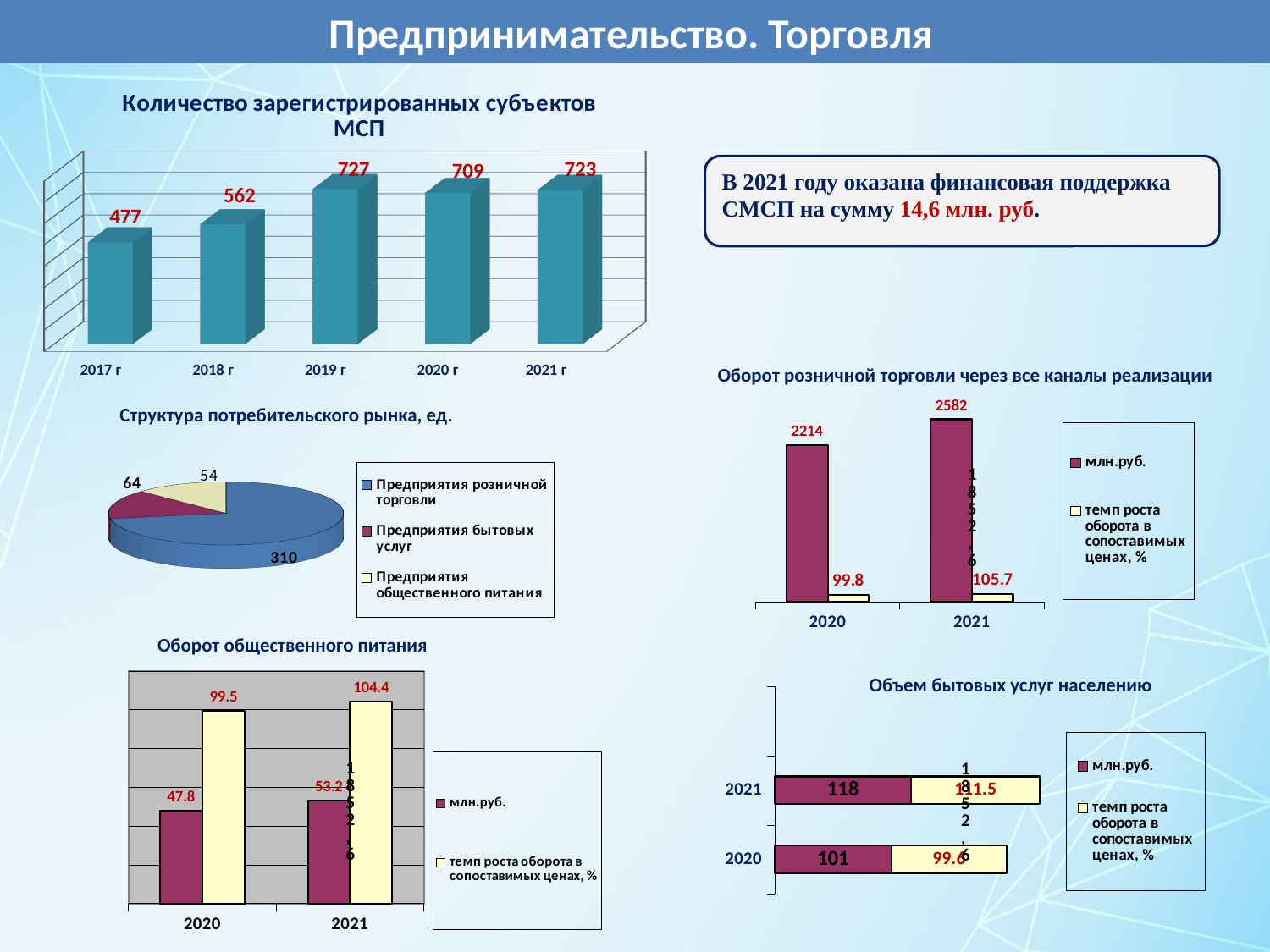
On the chart 'Структура потребительского рынка, ед.', what is the value for Предприятия бытовых услуг? 64 On the chart 'Количество зарегистрированных субъектов МСП', how many years are shown? 5 On the chart 'Объем бытовых услуг населению', which year has the larger value in млн.руб., 2020 or 2021? 2021 What kind of chart is 'Структура потребительского рынка, ед.'? pie chart On the chart 'Структура потребительского рынка, ед.', which category has the largest slice? Предприятия розничной торговли On the chart 'Оборот розничной торговли через все каналы реализации', what is the value in млн.руб. for 2021? 2582 On the chart 'Количество зарегистрированных субъектов МСП', what is the difference between the values for 2018 г and 2017 г? 85 On the chart 'Оборот общественного питания', what is the темп роста оборота в сопоставимых ценах, % for 2021? 104.4 On the chart 'Количество зарегистрированных субъектов МСП', what is the value for 2019 г? 727 On the chart 'Количество зарегистрированных субъектов МСП', which year has the lowest value? 2017 г On the chart 'Оборот общественного питания', how many series does the legend list? 2 On the chart 'Оборот розничной торговли через все каналы реализации', what is the difference in млн.руб. between 2021 and 2020? 368